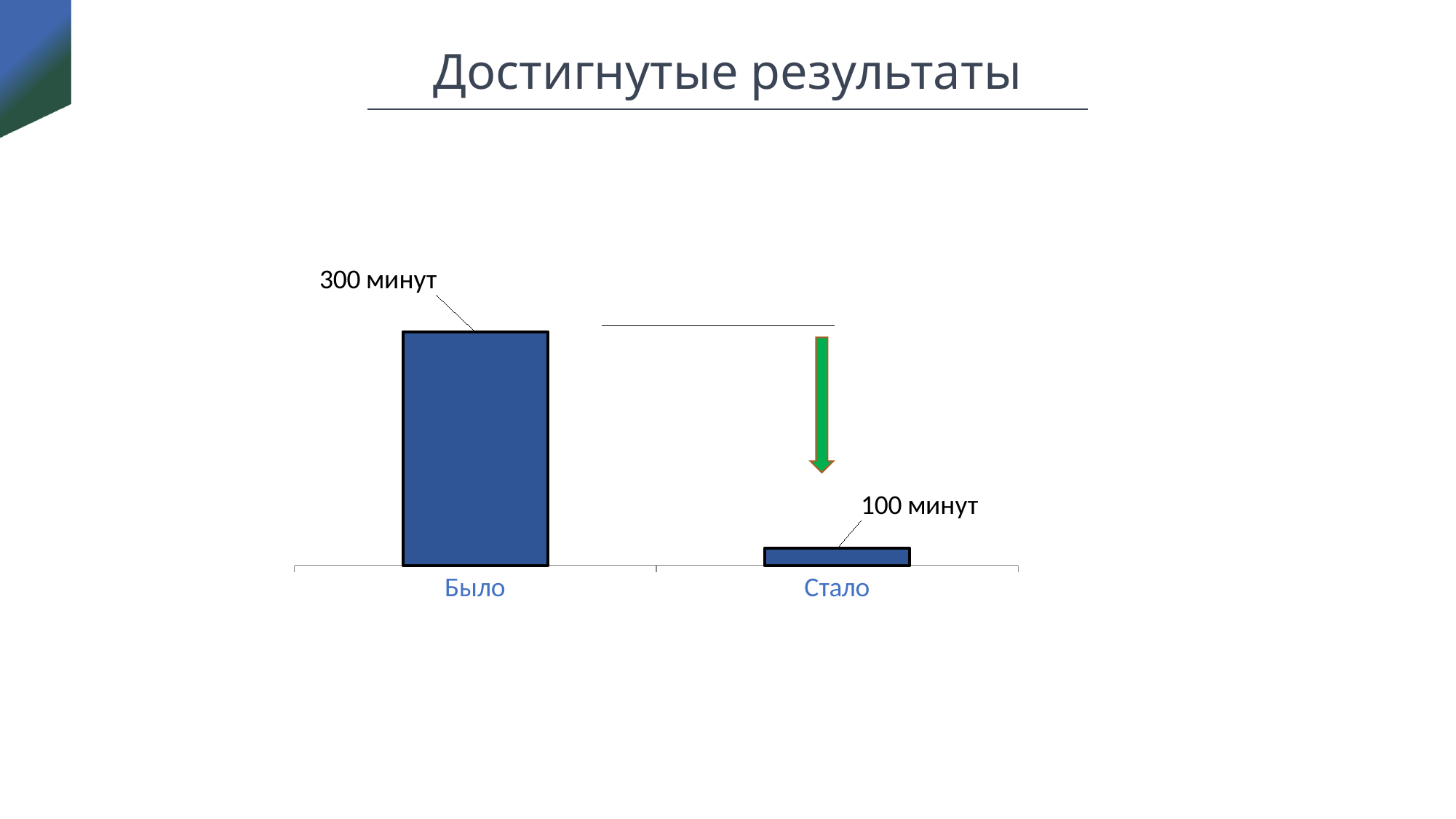
Which category has the lowest value? Стало Which is larger, the value for Было or the value for Стало? Было What is the difference between the values for Было and Стало? 200 минут Which category has the highest value? Было What kind of chart is shown on the slide? bar chart What is the value for Стало? 100 минут Do the values rise or fall from Было to Стало? fall What is the title of the slide containing the chart? Достигнутые результаты How many categories are shown in the chart? 2 What colour are the bars in the chart? blue What is the value for Было? 300 минут